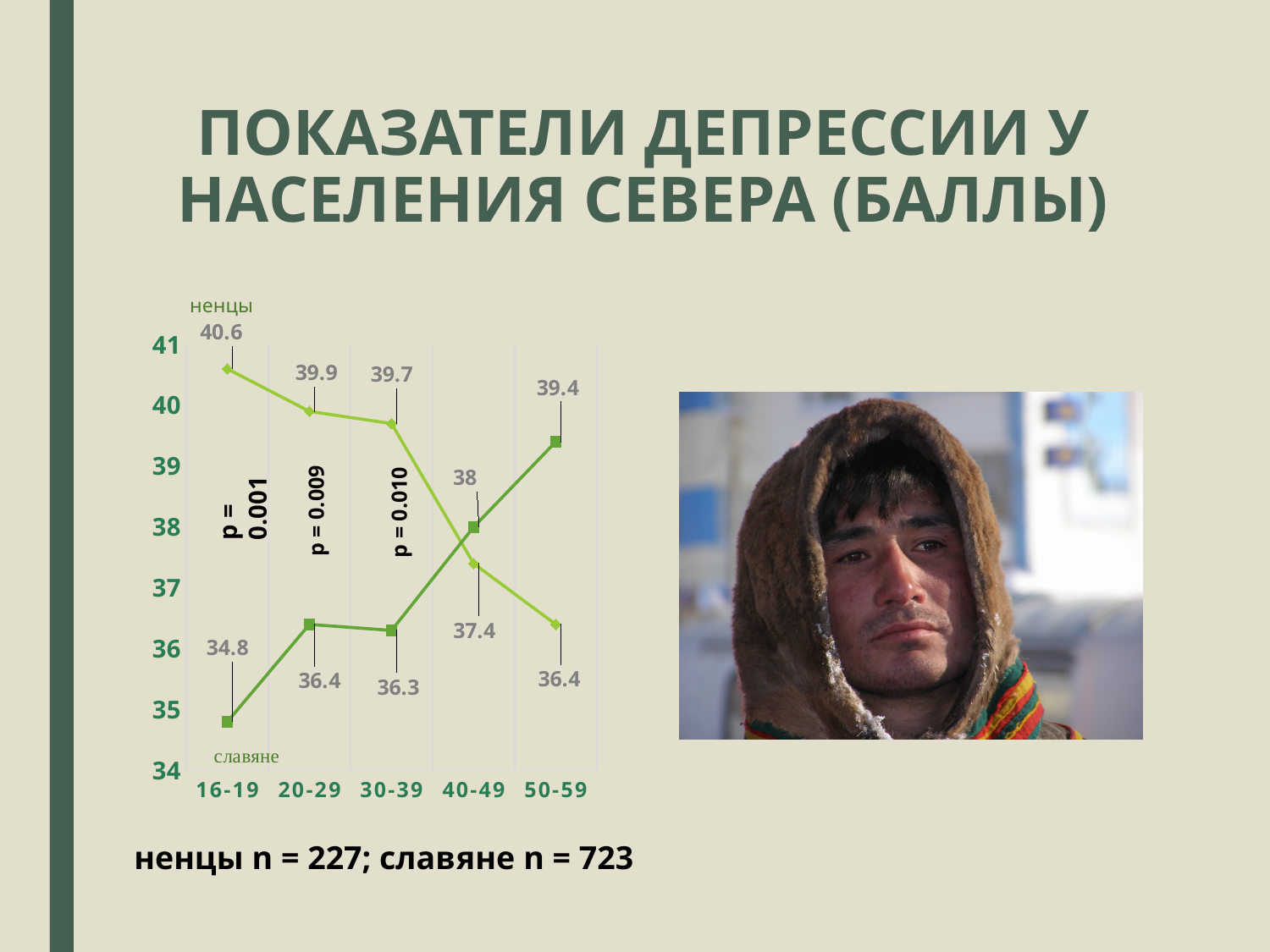
What is the depression score for ненцы in the 16-19 age group? 40.6 How many series are plotted on the chart? 2 In which age group is the depression score for ненцы highest? 16-19 Do the depression scores for ненцы rise or fall across the age groups from 16-19 to 50-59? fall In which age group is the depression score for славяне lowest? 16-19 What is the difference between the ненцы and славяне scores in the 16-19 age group? 5.8 What is the depression score for ненцы in the 40-49 age group? 37.4 Which group has the higher depression score in the 50-59 age group, ненцы or славяне? славяне What is the depression score for славяне in the 40-49 age group? 38 How many age groups are shown on the x axis of the chart? 5 What is the depression score for славяне in the 50-59 age group? 39.4 What type of chart is shown on the slide? line chart